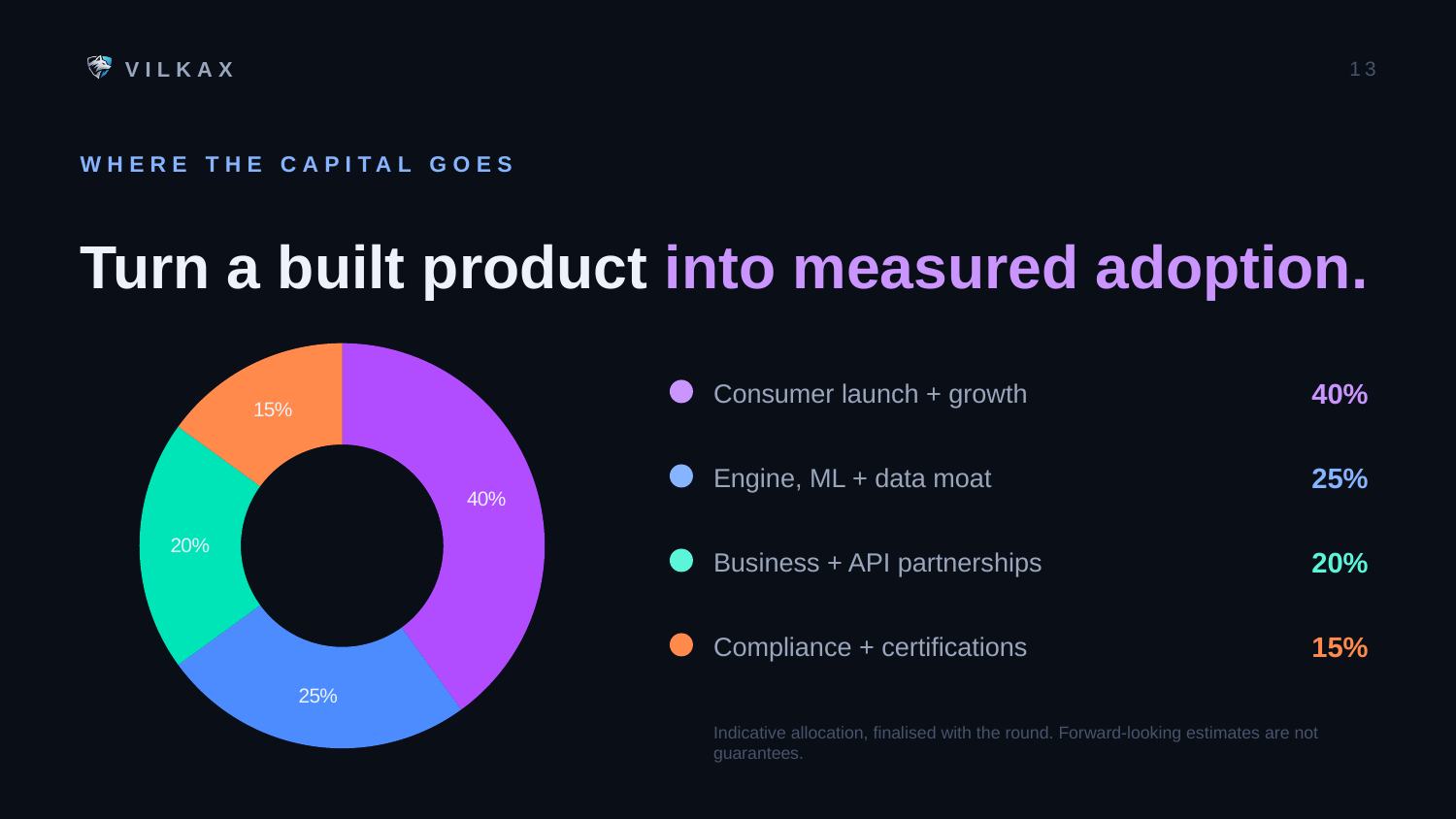
What colour represents Compliance + certifications in the chart? Orange Which category receives the smallest share of the capital? Compliance + certifications What kind of chart is shown on the slide? Pie chart (donut) Which category receives the largest share of the capital? Consumer launch + growth What is the difference in percentage points between Consumer launch + growth and Engine, ML + data moat? 15 What percentage is allocated to Business + API partnerships? 20% How many categories are shown in the pie chart? 4 What percentage is allocated to Engine, ML + data moat? 25% What percentage is allocated to Compliance + certifications? 15% What is the combined share of Engine, ML + data moat and Business + API partnerships? 45% Which is larger: the share for Business + API partnerships or the share for Compliance + certifications? Business + API partnerships What share of the capital allocation goes to Consumer launch + growth? 40%